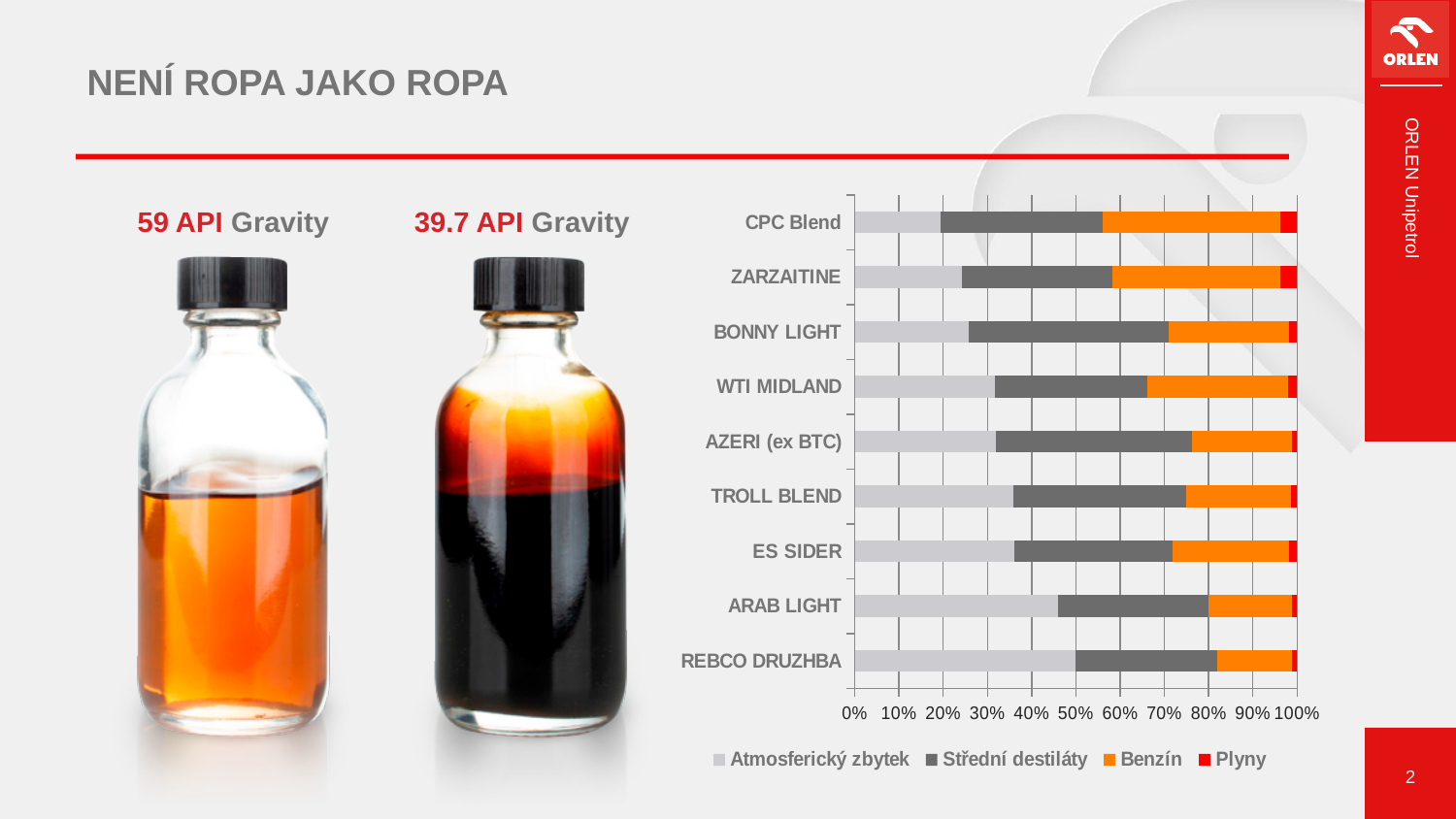
Is the Atmosferický zbytek share for CPC Blend greater or less than 30%? less Which has a larger Atmosferický zbytek share, CPC Blend or REBCO DRUZHBA? REBCO DRUZHBA How many series does the chart legend list? 4 Which series is shown in orange in the chart legend? Benzín What kind of chart is shown on the slide? stacked bar chart Which crude has the smallest Atmosferický zbytek share? CPC Blend How many crude oil types (categories) are listed on the chart? 9 Which has a larger Benzín share, CPC Blend or REBCO DRUZHBA? CPC Blend Is the Plyny share for CPC Blend greater or less than 10%? less Is the Atmosferický zbytek share for ARAB LIGHT greater or less than 40%? greater Which series is shown in red in the chart legend? Plyny Which crude has the largest Atmosferický zbytek share? REBCO DRUZHBA